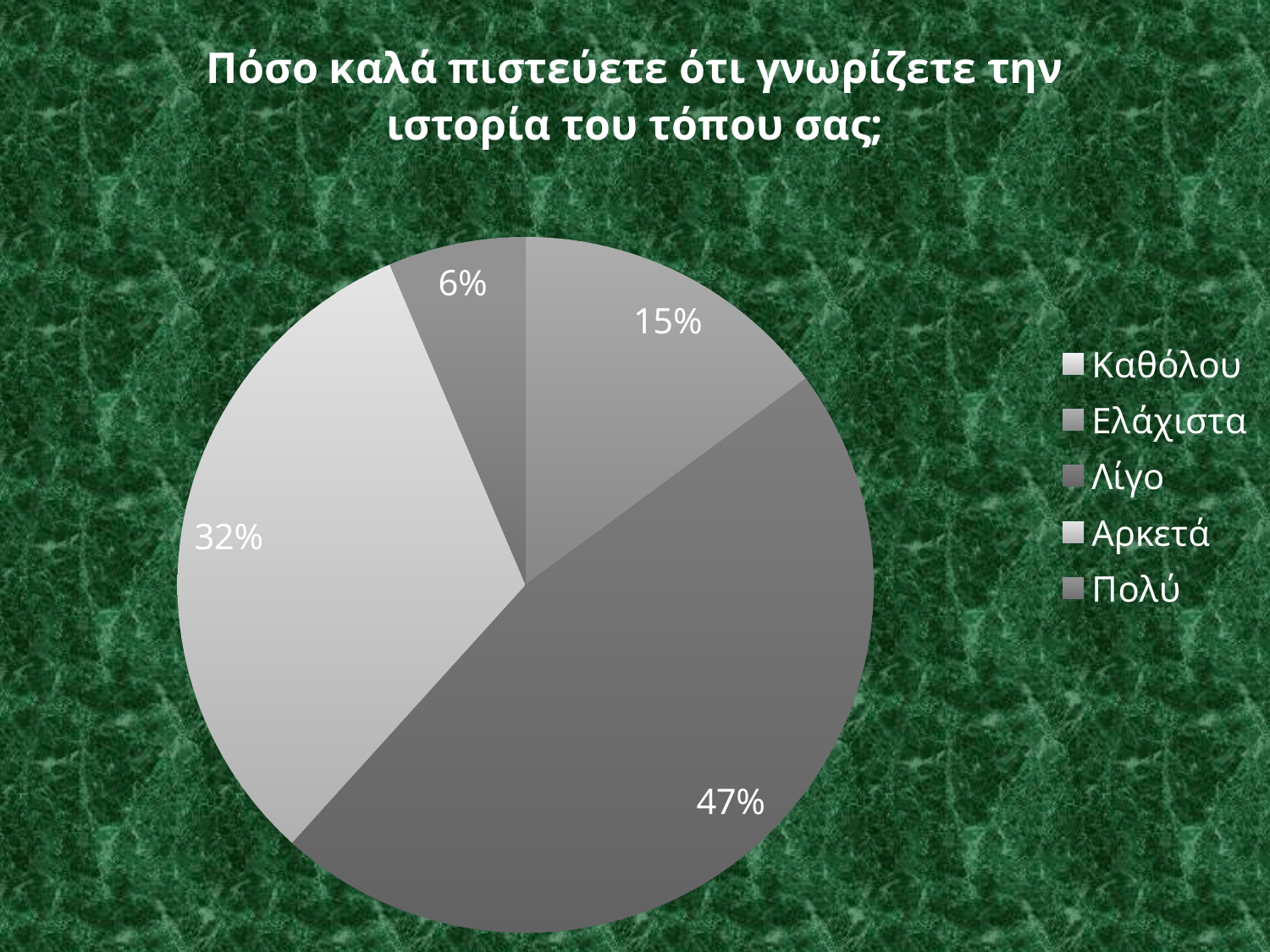
What share of the pie does the Αρκετά slice represent? 32% What share of the pie does the Ελάχιστα slice represent? 15% What is the title of the chart? Πόσο καλά πιστεύετε ότι γνωρίζετε την ιστορία του τόπου σας; What is the largest percentage shown on the pie chart? 47% How many entries does the legend list? 5 What kind of chart is shown on the slide? pie chart What is the smallest percentage labelled on the pie chart? 6% What is the difference between the largest slice (47%) and the 32% slice? 15% How many percentage labels are printed on the pie chart? 4 What share of the pie does the Λίγο slice represent? 47% Which is larger, the Λίγο slice or the Αρκετά slice? Λίγο